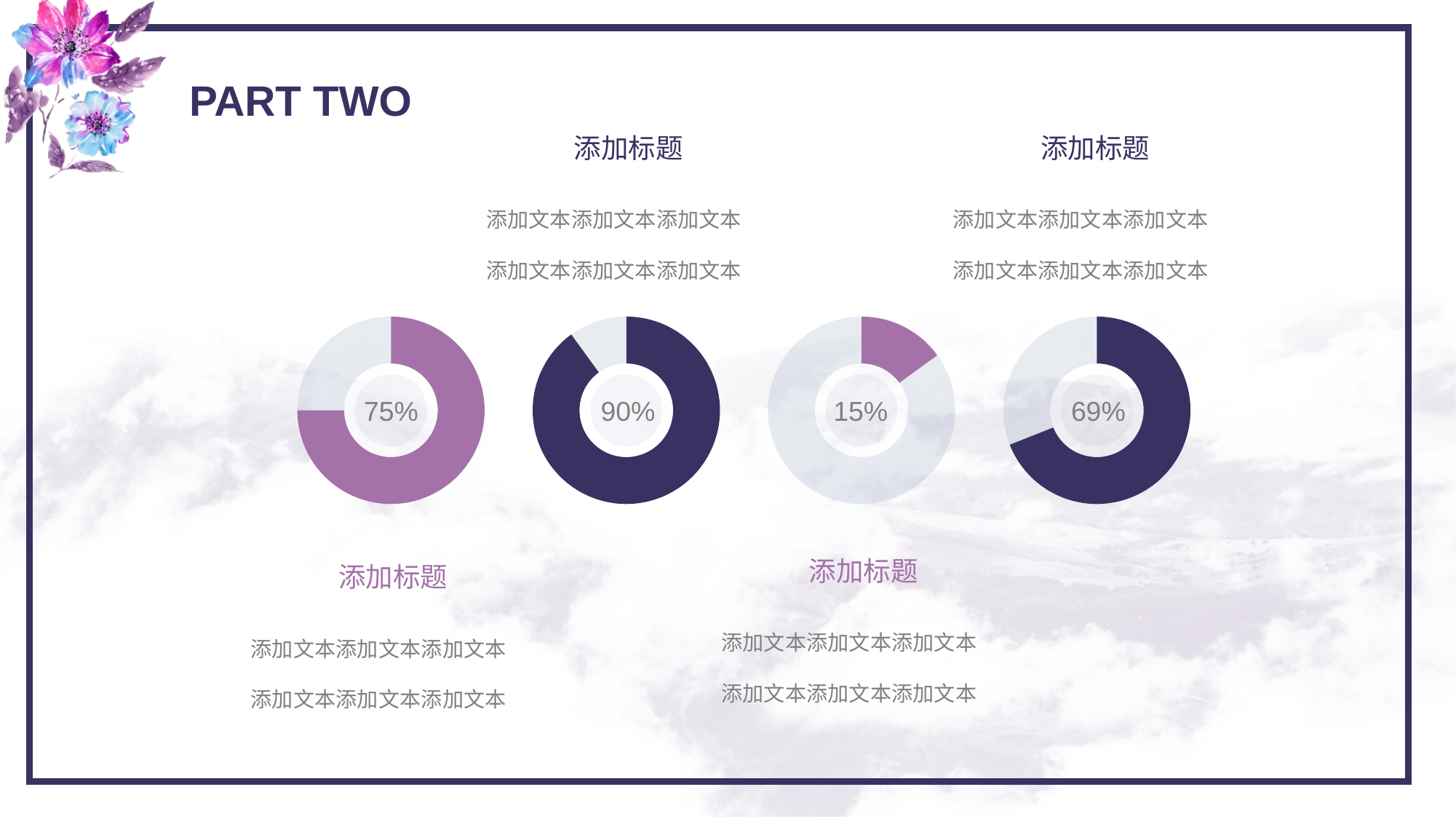
What value is shown in the centre of the rightmost donut chart? 69% What colour is the filled portion of the leftmost donut chart? Purple Which of the four donut charts shows the highest percentage? The second from the left (90%) Which is larger: the value in the leftmost donut chart or the value in the rightmost donut chart? The leftmost (75%) What is the difference between the value in the leftmost donut chart and the value in the third donut chart from the left? 60% What value is shown in the centre of the second donut chart from the left? 90% How many donut charts are shown on the slide? 4 Which of the four donut charts shows the lowest percentage? The third from the left (15%) What value is shown in the centre of the third donut chart from the left? 15% What is the difference between the value in the second donut chart from the left and the value in the rightmost donut chart? 21% What kind of chart is used to display the percentages on this slide? Donut chart What value is shown in the centre of the leftmost donut chart? 75%